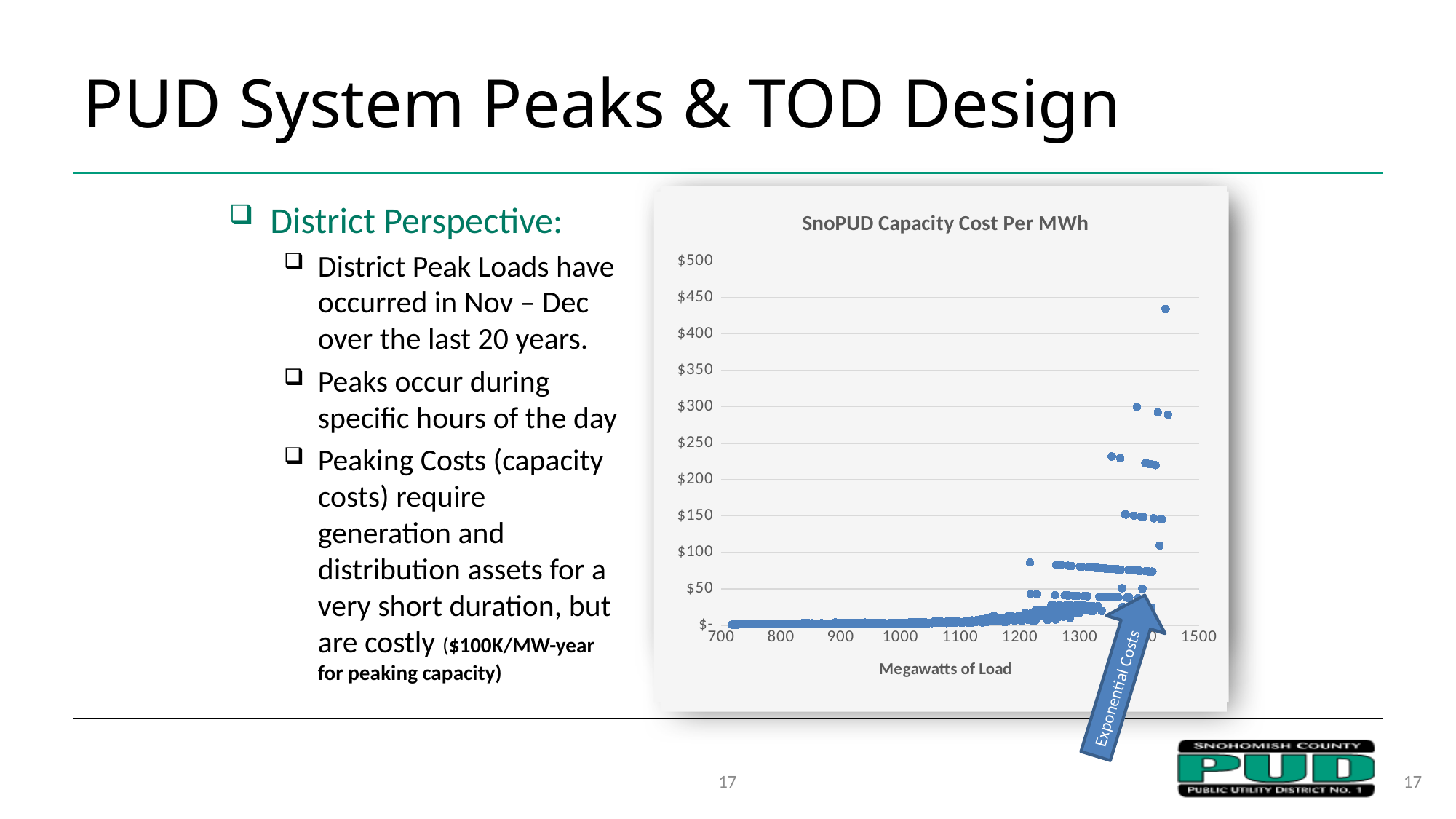
Is the capacity cost at 1000 megawatts of load greater or less than $100? less What kind of chart is shown on the slide? scatter chart Which has the higher capacity cost: the highest point near 1450 megawatts of load or the points near 800 megawatts of load? the highest point near 1450 megawatts Is the highest plotted capacity cost greater or less than $400? greater What is the label of the x axis of the chart? Megawatts of Load Are the capacity costs for loads between 700 and 1100 megawatts greater or less than $50? less What is the title of the chart on the slide? SnoPUD Capacity Cost Per MWh Do capacity costs generally rise or fall as megawatts of load increase along the x axis? rise What is the highest value shown on the y axis of the chart? $500